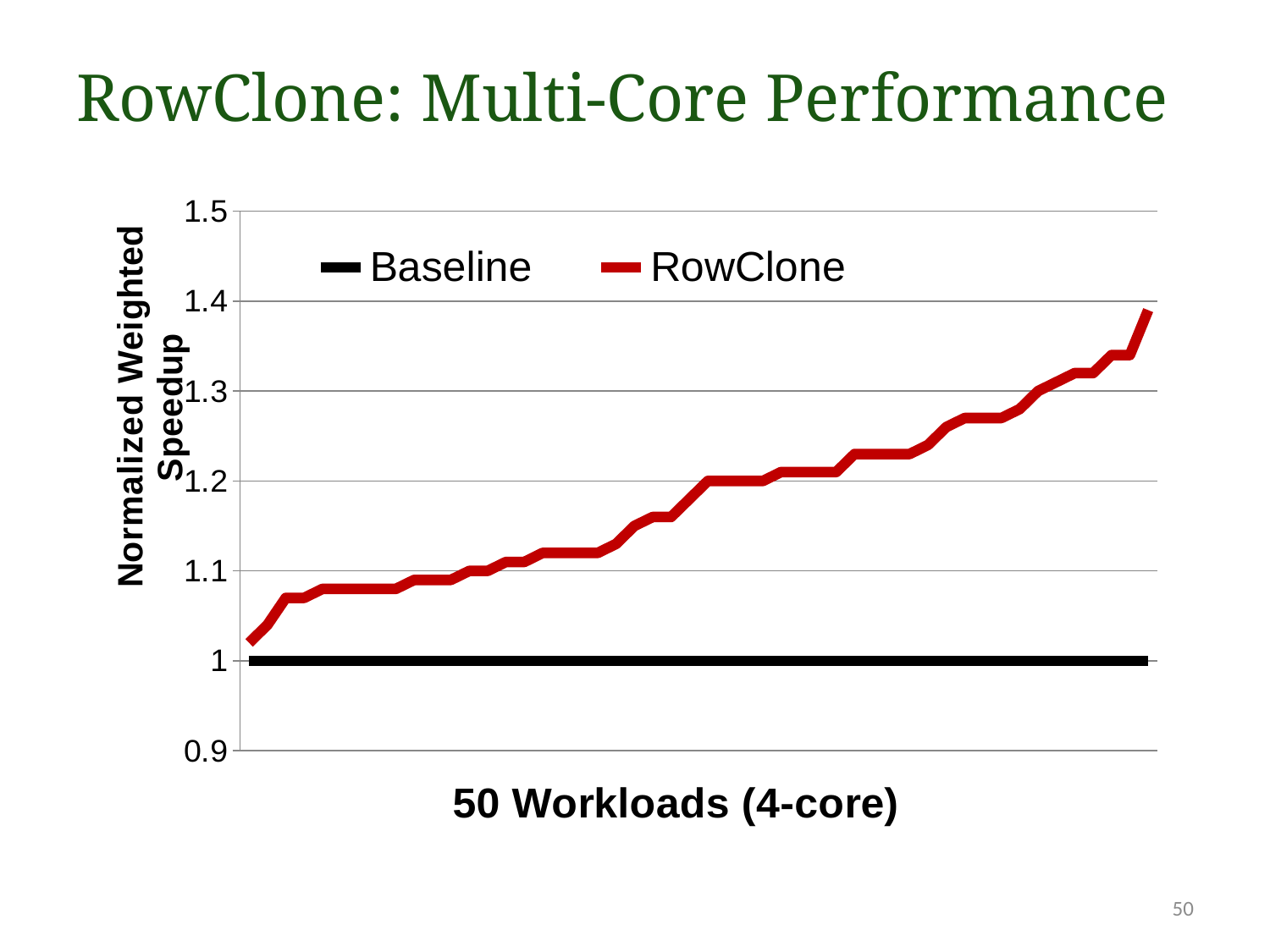
Does the RowClone series rise or fall along the x axis? rise What is the normalized weighted speedup of the Baseline series across all workloads? 1 How many workloads are plotted along the x axis? 50 Is the lowest RowClone value greater or less than 1.1? less Is the highest RowClone value greater or less than 1.3? greater What is the label on the x axis? 50 Workloads (4-core) Which series has the higher values across the workloads, Baseline or RowClone? RowClone What are the two series named in the legend? Baseline and RowClone How many series does the legend list? 2 What is the title of the slide's chart? RowClone: Multi-Core Performance What kind of chart is shown on the slide? line chart